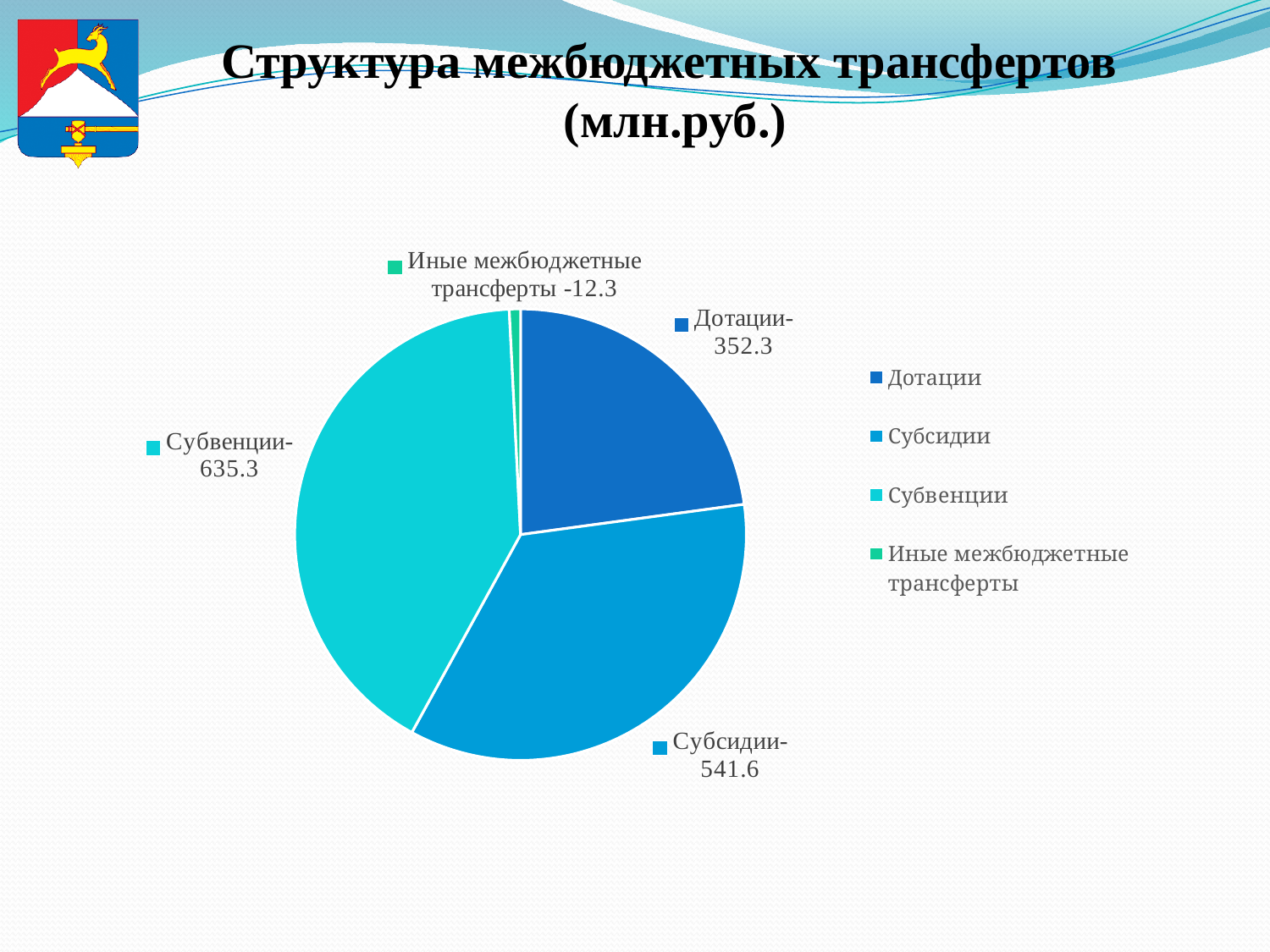
What is the value for Иные межбюджетные трансферты? 12.3 What is the value for Субвенции? 635.3 What kind of chart is shown on the slide? Pie chart Which is larger, the value for Дотации or the value for Субсидии? Субсидии Which category has the largest slice of the pie? Субвенции What is the value for Субсидии? 541.6 What is the difference between the values for Субсидии and Дотации? 189.3 How many categories does the pie chart show? 4 What is the difference between the values for Субвенции and Субсидии? 93.7 What is the title of the chart on the slide? Структура межбюджетных трансфертов (млн.руб.) Which category has the smallest slice of the pie? Иные межбюджетные трансферты What is the value for Дотации? 352.3